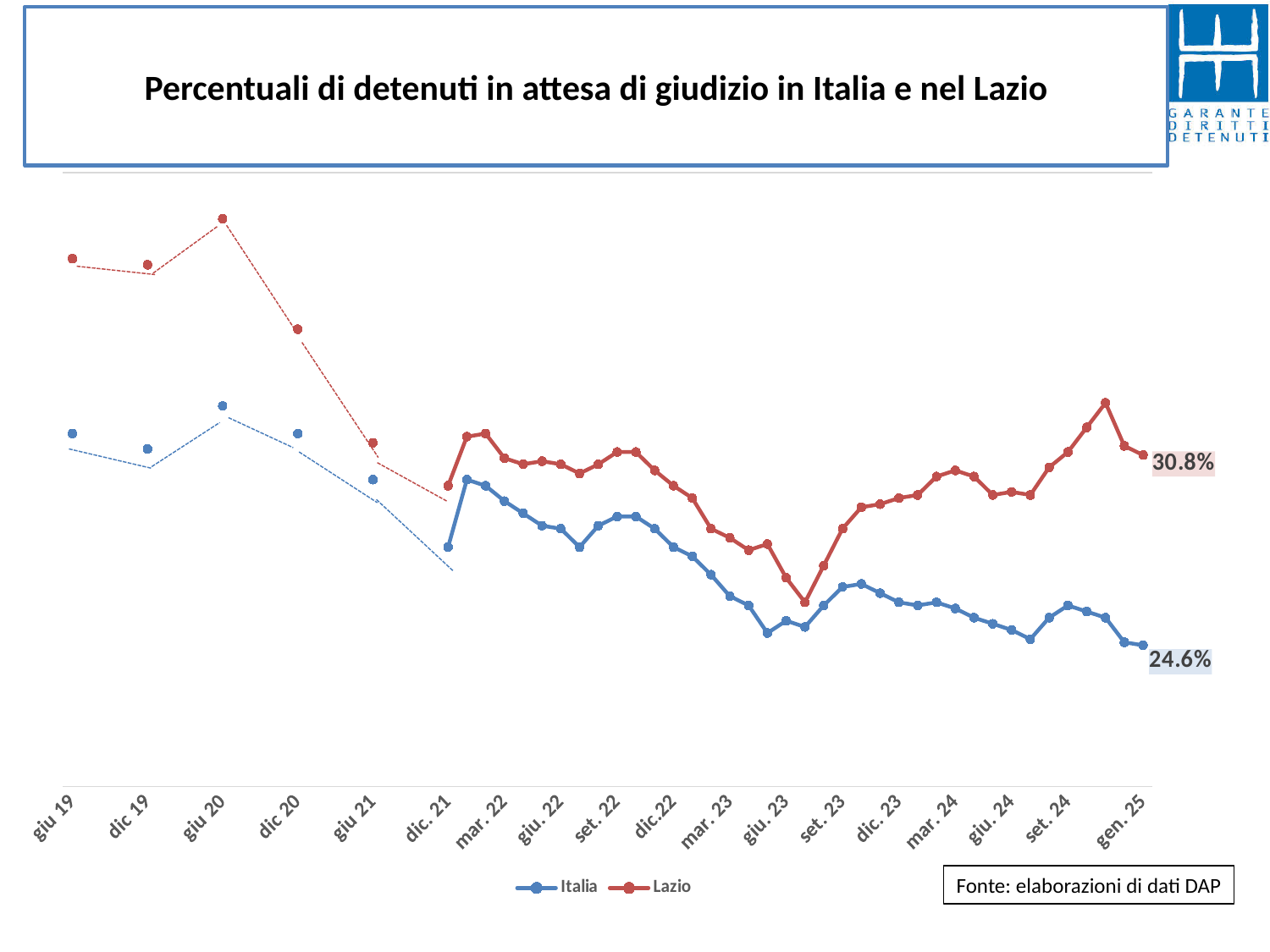
What is the title of the chart? Percentuali di detenuti in attesa di giudizio in Italia e nel Lazio What kind of chart is shown on the slide? Line chart What is the value for Italia at gen. 25? 24.6% At gen. 25, which series has the higher value, Italia or Lazio? Lazio How many series does the legend list? 2 Which series is drawn in red? Lazio What is the difference between the Lazio and Italia values at gen. 25? 6.2 percentage points What is the value for Lazio at gen. 25? 30.8% At which date does the Lazio series reach its highest value? giu 20 At which date does the Italia series reach its highest value? giu 20 Does the Italia series overall rise or fall from mar. 22 to gen. 25? Fall